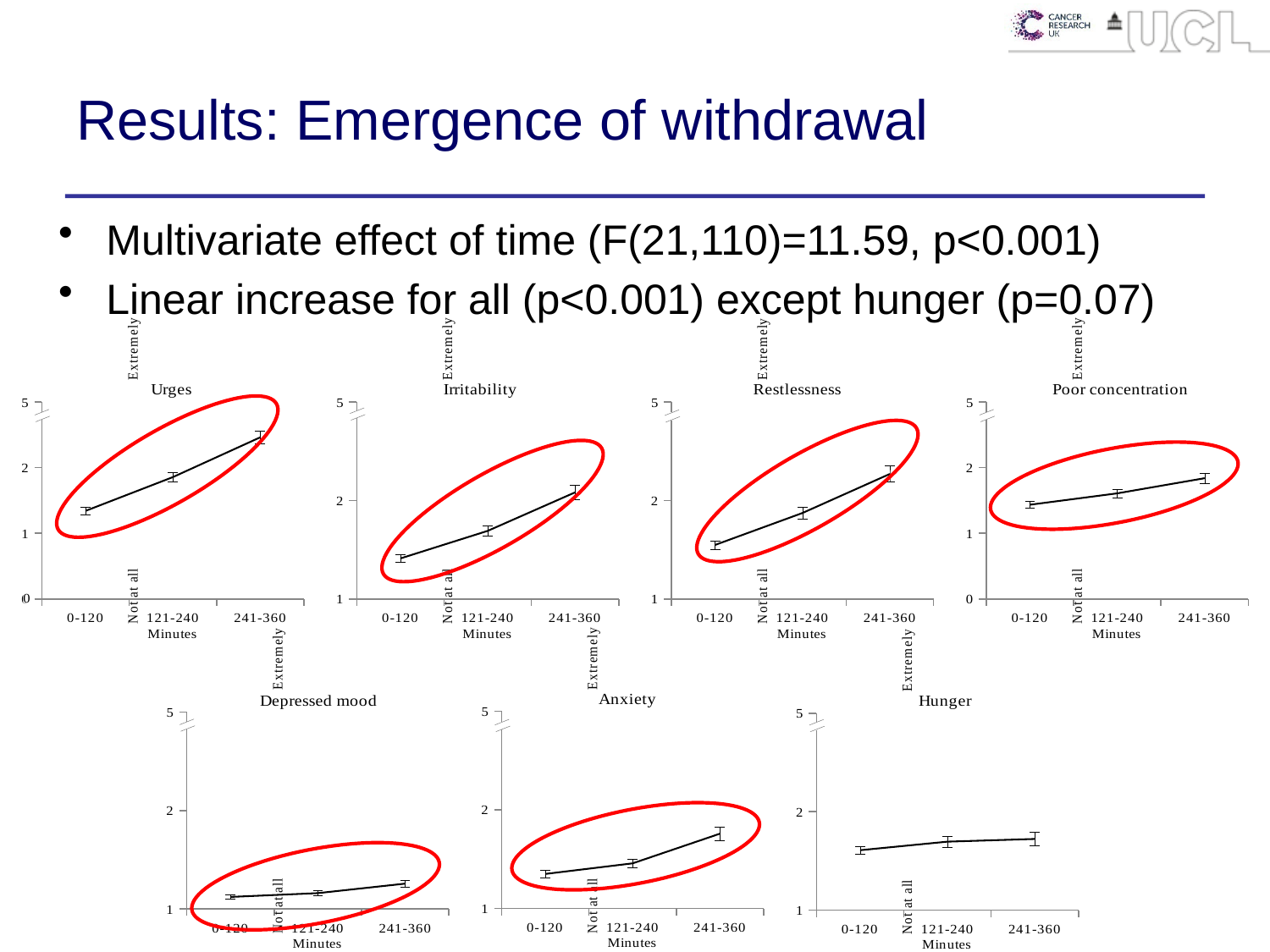
In the Restlessness chart, is the value for 241-360 minutes greater or less than 2? greater In the Restlessness chart, do the values rise or fall across the time periods? rise How many charts are shown on the slide? 7 What is the x-axis label on the Hunger chart? Minutes What kind of chart is the Urges chart? line chart In the Urges chart, do the values rise or fall from 0-120 to 241-360 minutes? rise In the Anxiety chart, is the value for 241-360 minutes greater or less than 2? less In the Irritability chart, which is larger, the value for 0-120 minutes or for 241-360 minutes? 241-360 How many time-period categories are on the x axis of the Irritability chart? 3 In the Urges chart, which time period has the highest value? 241-360 In the Urges chart, is the value for 241-360 minutes greater or less than 2? greater